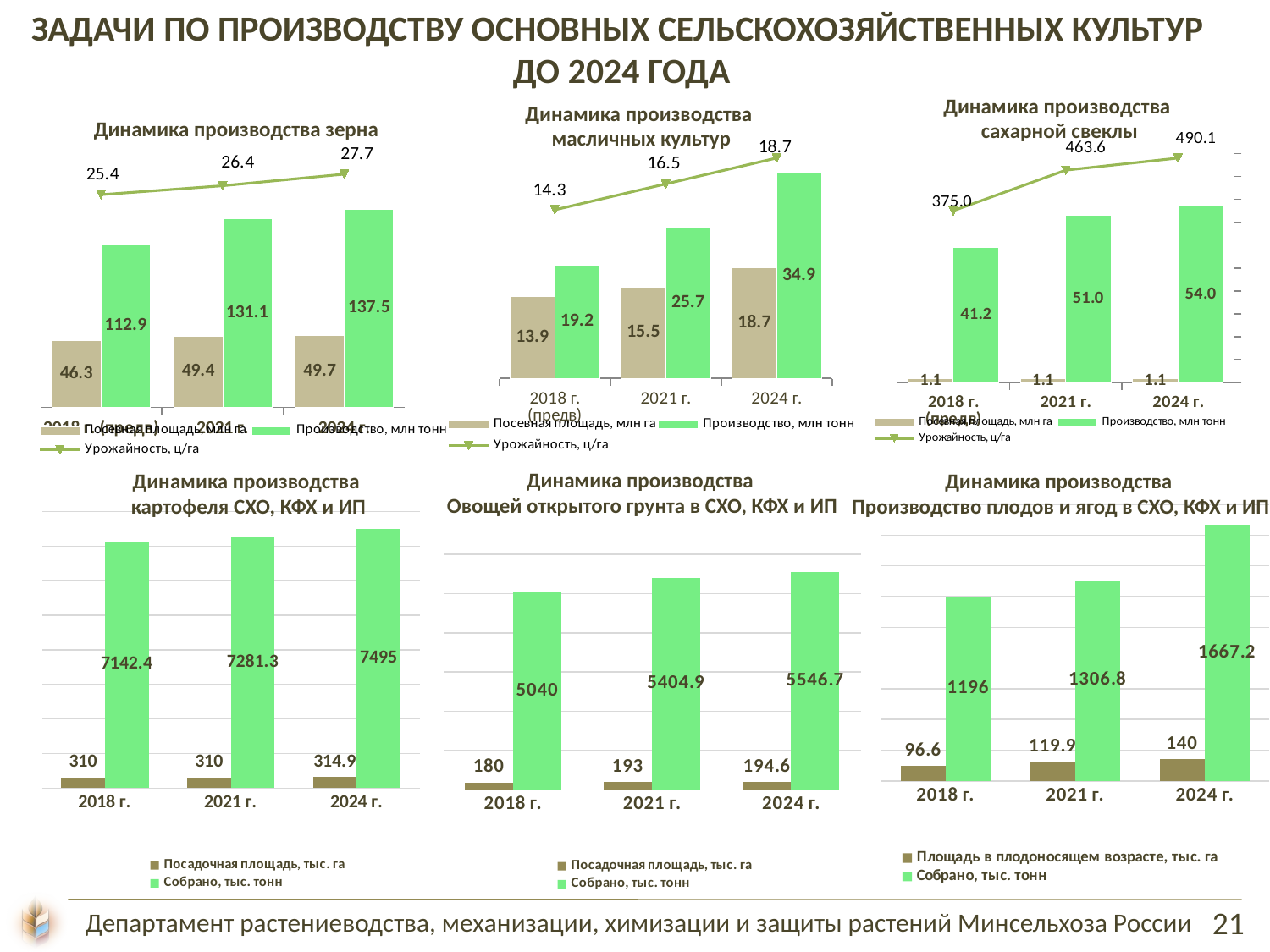
In the chart 'Динамика производства масличных культур', what is the value of 'Посевная площадь, млн га' for 2021 г.? 15.5 In the chart 'Производство плодов и ягод в СХО, КФХ и ИП', which year has the lowest 'Площадь в плодоносящем возрасте, тыс. га'? 2018 г. How many series does the legend of the chart 'Динамика производства сахарной свеклы' list? 3 In the chart 'Динамика производства картофеля СХО, КФХ и ИП', what is the value of 'Собрано, тыс. тонн' for 2021 г.? 7281.3 In the chart 'Динамика производства картофеля СХО, КФХ и ИП', does 'Собрано, тыс. тонн' rise or fall from 2018 г. to 2024 г.? rise In the chart 'Динамика производства сахарной свеклы', which year has the highest 'Урожайность, ц/га'? 2024 г. In the chart 'Динамика производства зерна', what is the value of 'Производство, млн тонн' for 2024 г.? 137.5 In the chart 'Динамика производства сахарной свеклы', what is the value of 'Производство, млн тонн' for 2021 г.? 51.0 In the chart 'Производство плодов и ягод в СХО, КФХ и ИП', which is larger: 'Собрано, тыс. тонн' for 2021 г. or for 2024 г.? 2024 г. In the chart 'Динамика производства масличных культур', what is the difference in 'Производство, млн тонн' between 2024 г. and 2018 г. (предв)? 15.7 In the chart 'Динамика производства зерна', what is the value of 'Урожайность, ц/га' for 2018 г. (предв)? 25.4 In the chart 'Динамика производства Овощей открытого грунта в СХО, КФХ и ИП', what is the value of 'Посадочная площадь, тыс. га' for 2018 г.? 180